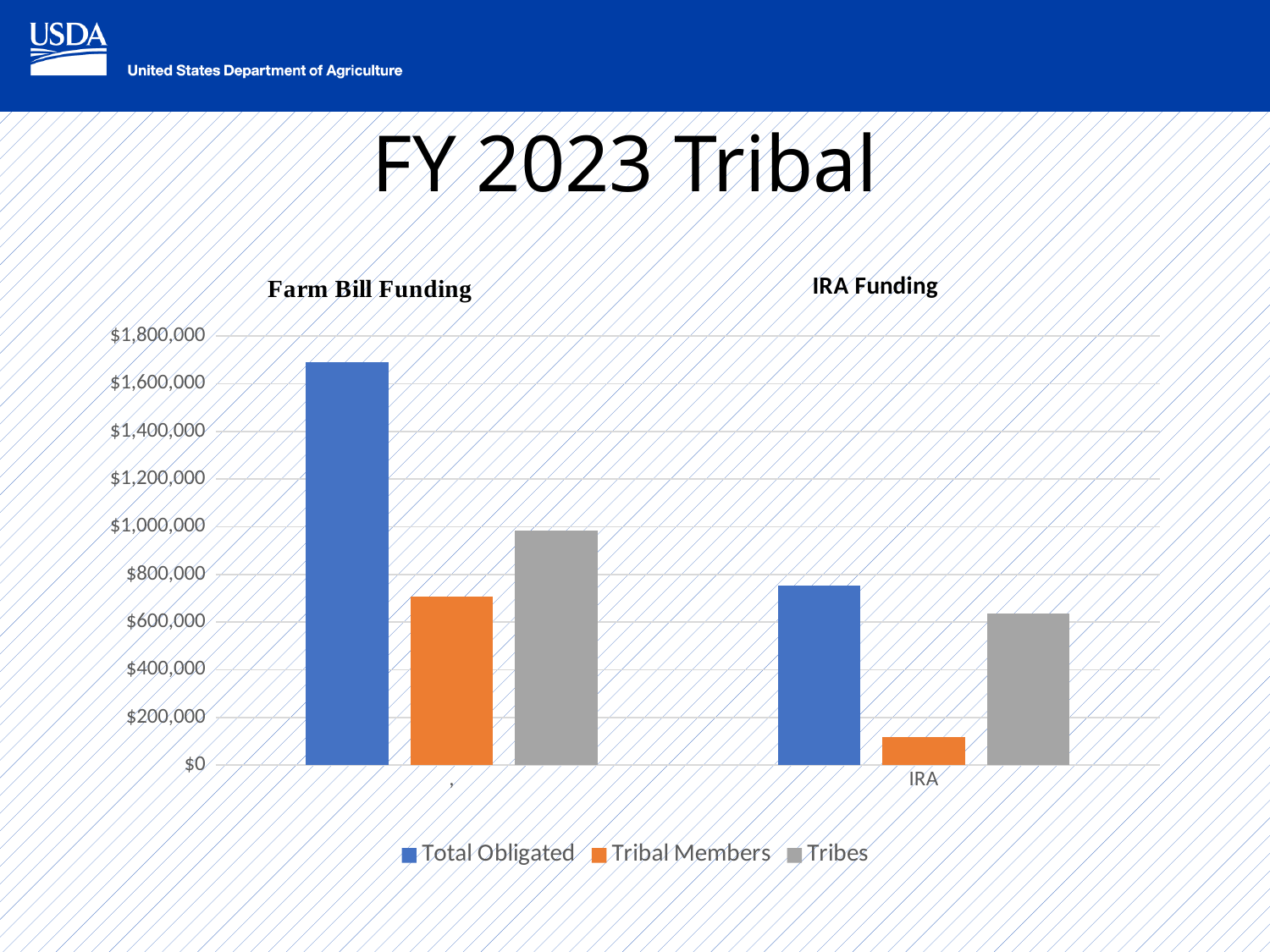
How many series does the legend list? 3 Is the Total Obligated value for Farm Bill Funding greater or less than $1,600,000? greater Which bar is the lowest on the chart? Tribal Members (IRA Funding) How many funding groups are plotted on the chart? 2 Is the Tribal Members value for IRA Funding greater or less than $200,000? less What kind of chart is shown on the slide? Bar chart Is the Total Obligated value for IRA Funding greater or less than $800,000? less Under Farm Bill Funding, which is larger: the Tribes bar or the Tribal Members bar? Tribes Which group has the larger Total Obligated bar, Farm Bill Funding or IRA Funding? Farm Bill Funding What colour represents the Tribal Members series in the legend? Orange Which series has the tallest bar on the chart? Total Obligated (Farm Bill Funding)